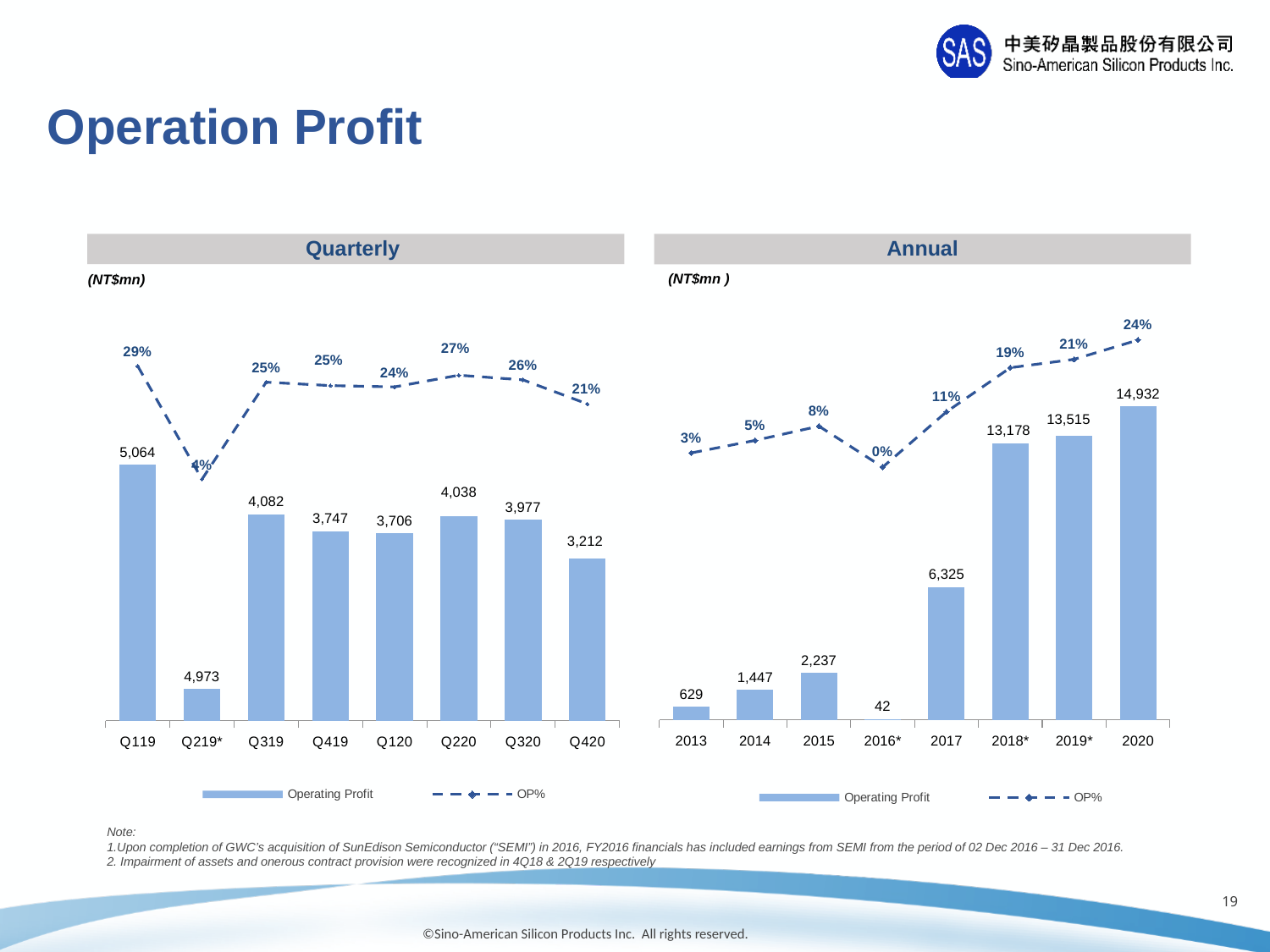
How many series does the legend of the Annual chart list? 2 In the Annual chart, does the OP% rise or fall from 2017 to 2020? rise In the Annual chart, what is the OP% for 2018*? 19% In the Annual chart, what is the operating profit for 2020? 14,932 In the Quarterly chart, what is the operating profit for Q120? 3,706 In the Annual chart, which year has the lowest operating profit? 2016* How many quarters are shown on the x axis of the Quarterly chart? 8 In the Quarterly chart, what is the OP% for Q220? 27% In the Annual chart, what is the difference in operating profit between 2020 and 2019*? 1,417 In the Annual chart, which year has the highest operating profit? 2020 In the Quarterly chart, which has the larger operating profit, Q319 or Q420? Q319 In the Quarterly chart, which quarter has the highest OP%? Q119